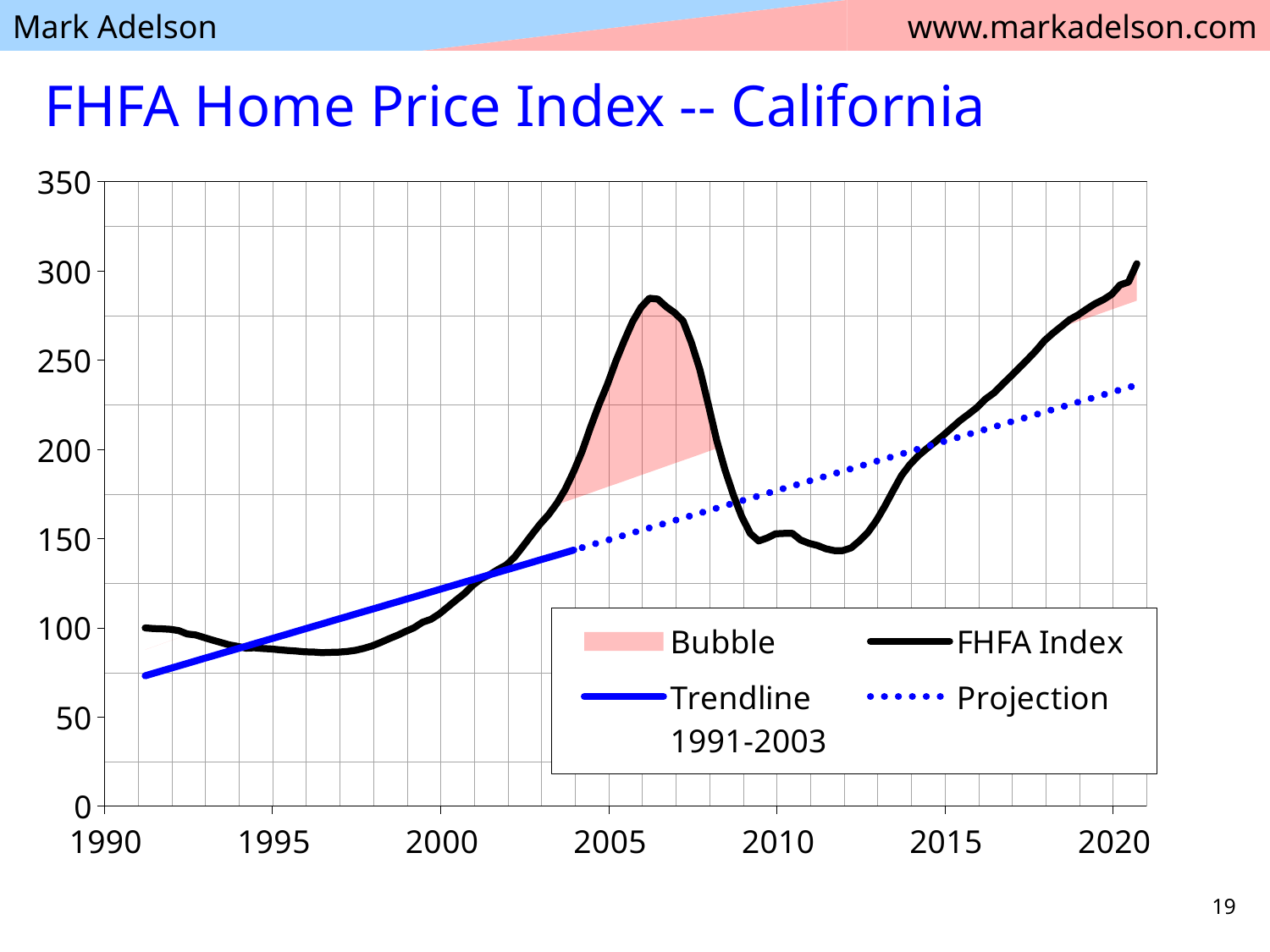
Is the value of the FHFA Index at the start of the series in 1991 greater or less than 150? less Is the value of the Trendline 1991-2003 at its start in 1991 greater or less than 100? less Is the value of the FHFA Index in 2012 greater or less than 150? less Does the FHFA Index rise or fall between 2006 and 2009? fall Which series is drawn as a dotted line? Projection Does the FHFA Index rise or fall between 2012 and 2020? rise In 2010, which is larger: the FHFA Index or the Projection? Projection What kind of chart is shown on the slide? line chart How many series does the legend list? 4 What is the title of the chart? FHFA Home Price Index -- California